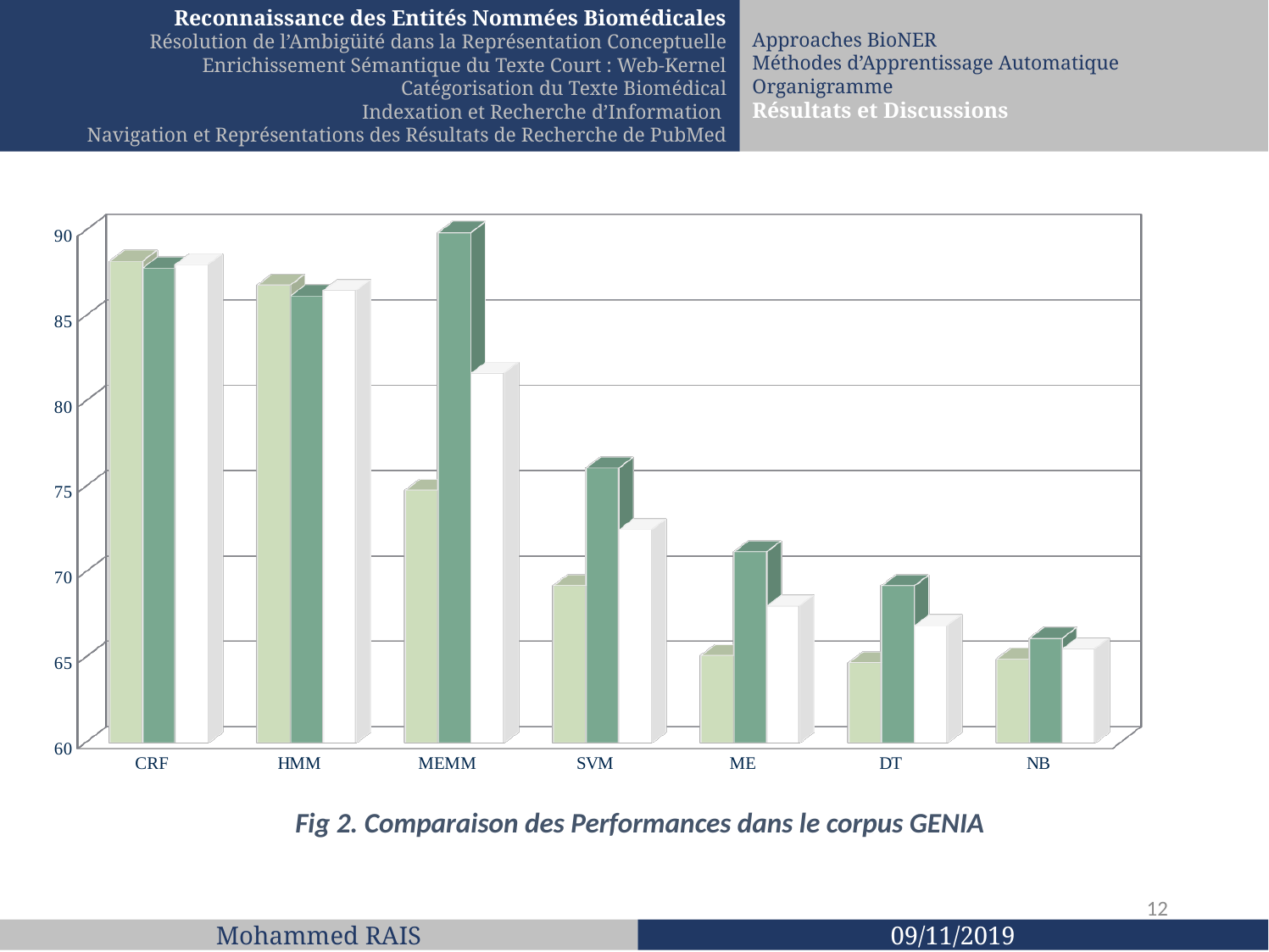
Is the value of the dark green bar for MEMM greater or less than 85? greater What is the caption of the figure shown below the chart? Fig 2. Comparaison des Performances dans le corpus GENIA Is the value of the light green bar for SVM greater or less than 70? less Do the dark green bars rise or fall from MEMM to NB along the x axis? fall Is the value of the light green bar for CRF greater or less than 85? greater Which category has the tallest bar in the chart? MEMM How many bars are plotted for each category in the chart? 3 How many categories are shown on the x axis of the chart? 7 Which has the larger light green bar, CRF or SVM? CRF What kind of chart is shown on the slide? Bar chart